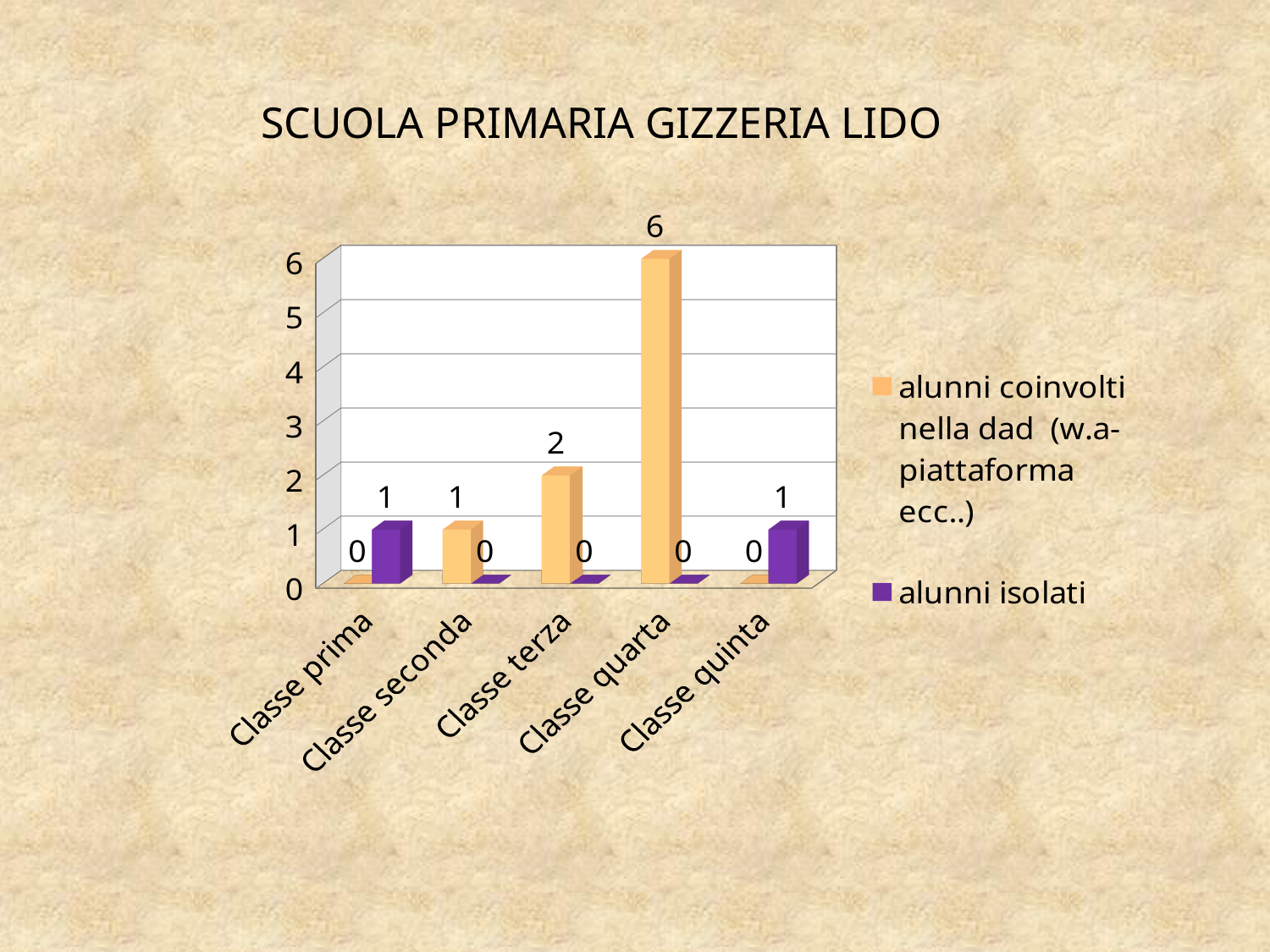
Which class has the highest value for 'alunni coinvolti nella dad'? Classe quarta What kind of chart is shown on the slide? Bar chart How many series does the legend list? 2 What is the value for 'alunni coinvolti nella dad' in Classe seconda? 1 What is the value for 'alunni coinvolti nella dad' in Classe terza? 2 What is the value for 'alunni isolati' in Classe prima? 1 Which is larger: 'alunni coinvolti nella dad' in Classe terza or in Classe seconda? Classe terza What is the difference between 'alunni coinvolti nella dad' in Classe quarta and in Classe terza? 4 How many classes are shown on the x axis? 5 What is the value for 'alunni coinvolti nella dad' in Classe quarta? 6 What is the title of the slide? SCUOLA PRIMARIA GIZZERIA LIDO What is the value for 'alunni isolati' in Classe quinta? 1